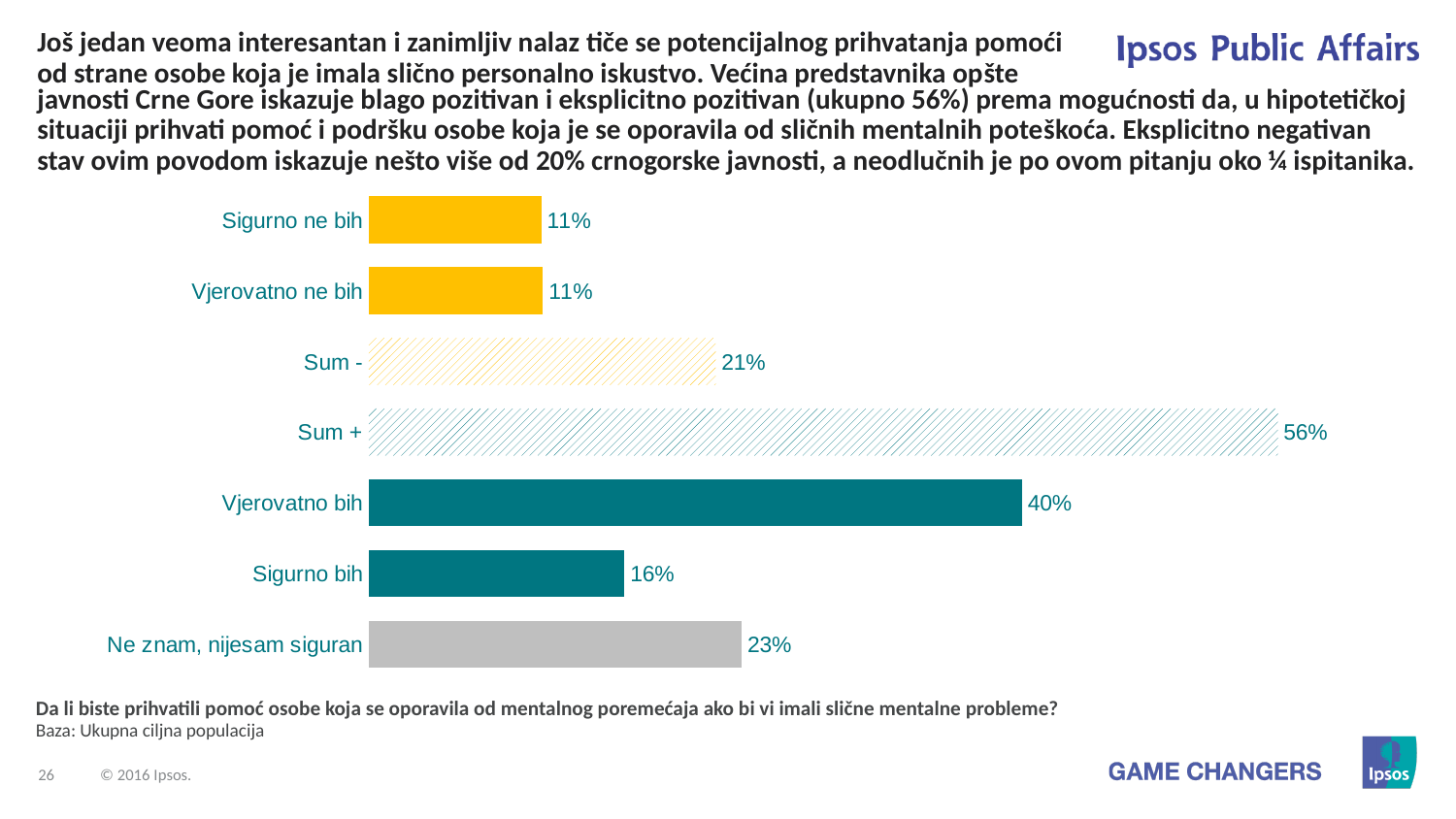
What is the value for "Vjerovatno bih"? 40% What is the value for "Sigurno bih"? 16% Which category has the highest value? Sum + What is the difference between "Sum +" and "Sum -"? 35% What is the value for "Sigurno ne bih"? 11% Which is larger, "Ne znam, nijesam siguran" or "Sigurno bih"? Ne znam, nijesam siguran Which two categories share the same value of 11%? Sigurno ne bih and Vjerovatno ne bih What is the value for "Ne znam, nijesam siguran"? 23% What is the value for "Sum +"? 56% What is the difference between "Vjerovatno bih" and "Sigurno bih"? 24% What kind of chart is shown on the slide? Bar chart How many categories are shown in the chart? 7